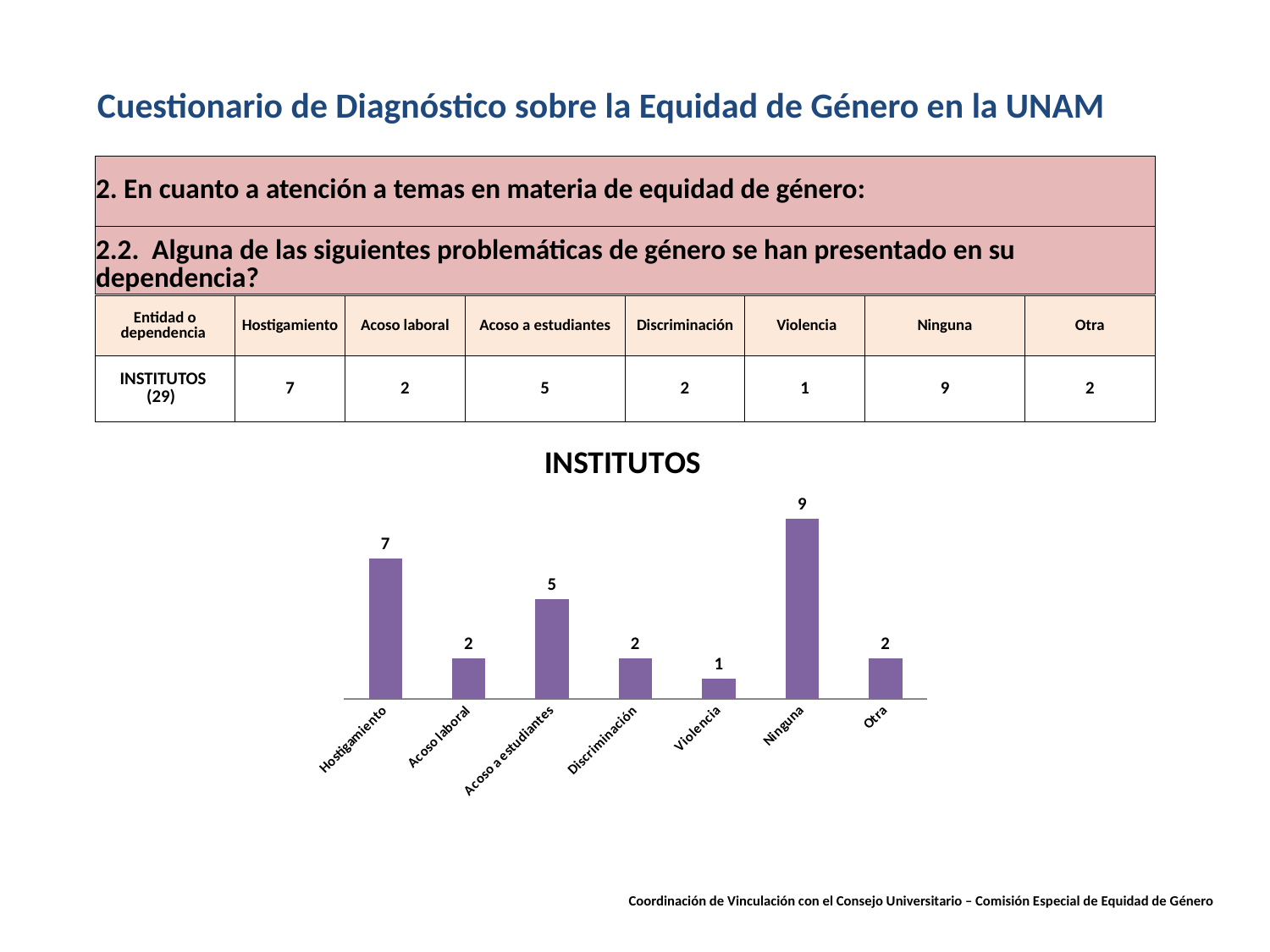
What is the difference between the values for Hostigamiento and Acoso a estudiantes in the INSTITUTOS chart? 2 Which category has the highest value in the INSTITUTOS chart? Ninguna What is the value for Violencia in the INSTITUTOS chart? 1 Which category has the lowest value in the INSTITUTOS chart? Violencia What is the value for Hostigamiento in the INSTITUTOS chart? 7 What is the title of the chart on the slide? INSTITUTOS What is the value for Ninguna in the INSTITUTOS chart? 9 Which is larger in the INSTITUTOS chart, Acoso a estudiantes or Acoso laboral? Acoso a estudiantes What is the difference between the values for Ninguna and Hostigamiento in the INSTITUTOS chart? 2 How many categories are shown in the INSTITUTOS chart? 7 What is the value for Acoso a estudiantes in the INSTITUTOS chart? 5 What kind of chart is shown on the slide? Bar chart